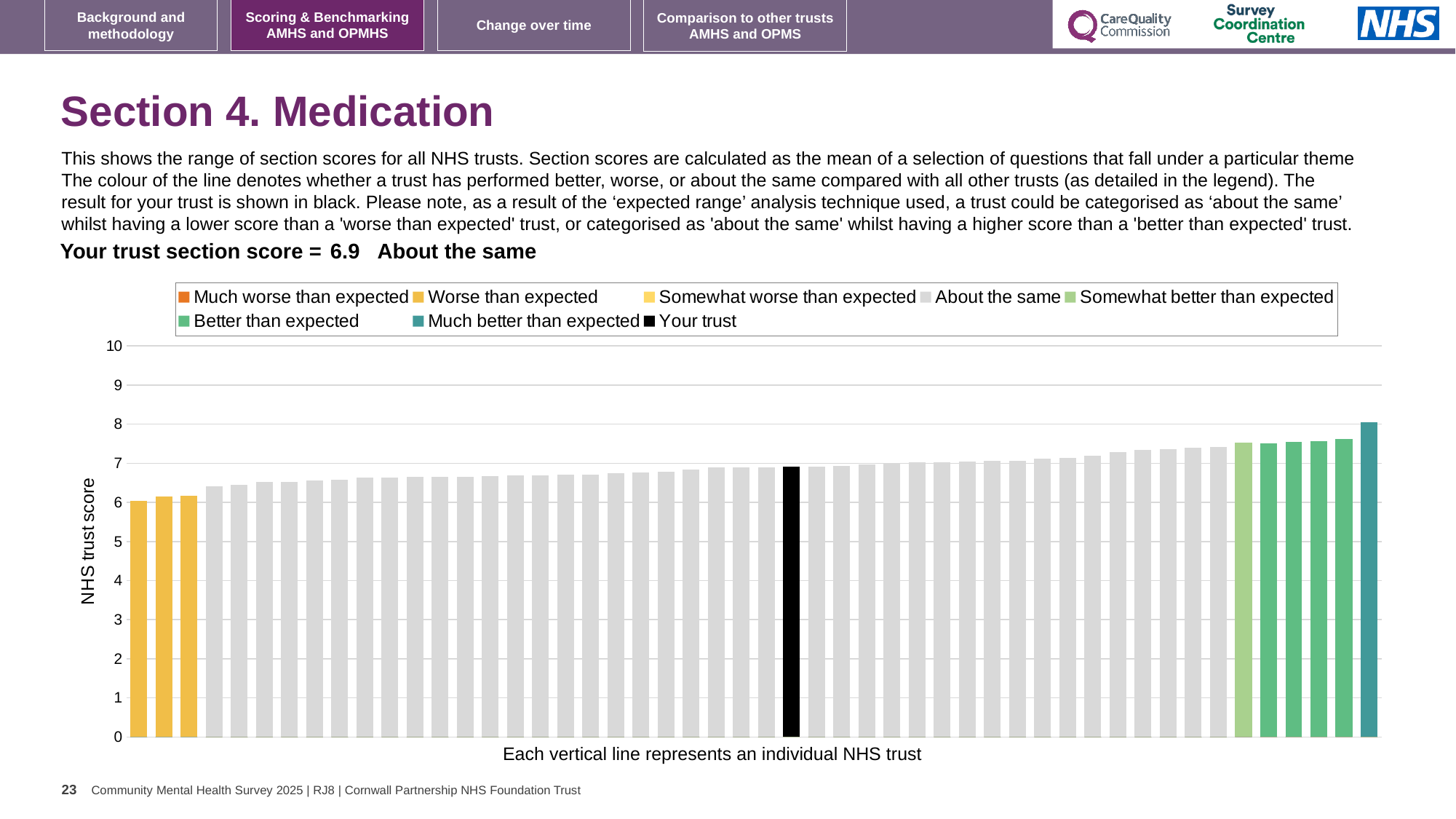
How many bars are coloured as 'Much better than expected'? 1 How many entries does the chart legend list? 8 Is the value of the highest bar greater or less than 7? greater What is the section score for your trust shown on the slide? 6.9 What is the label on the x axis of the chart? Each vertical line represents an individual NHS trust Which legend category does the lowest bar on the chart belong to? Worse than expected Is the value for your trust (the black bar) greater or less than 6? greater Which legend category does the highest bar on the chart belong to? Much better than expected Is the value for your trust (the black bar) greater or less than 7? less Do the bar values rise or fall from left to right along the x axis? rise What is the label on the y axis of the chart? NHS trust score What kind of chart is shown on the slide? bar chart